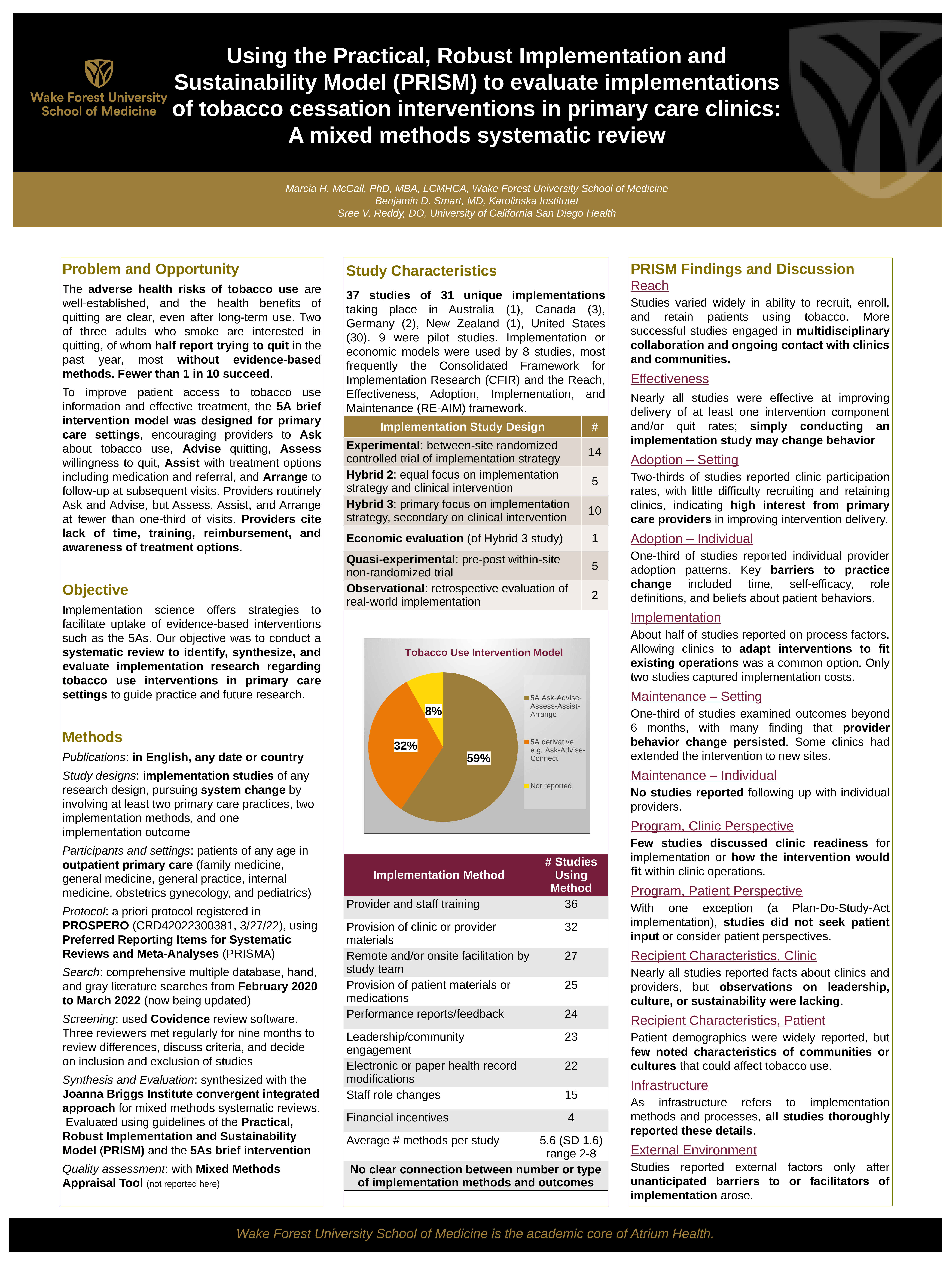
In the Tobacco Use Intervention Model pie chart, what share is labelled for 5A derivative e.g. Ask-Advise-Connect? 32% How many slices does the Tobacco Use Intervention Model pie chart have? 3 In the Tobacco Use Intervention Model pie chart, what colour is the Not reported slice? yellow Which slice of the Tobacco Use Intervention Model pie chart is the largest? 5A Ask-Advise-Assess-Assist-Arrange What kind of chart is the Tobacco Use Intervention Model chart? pie chart In the Tobacco Use Intervention Model pie chart, what is the difference in percentage points between the 5A Ask-Advise-Assess-Assist-Arrange slice and the 5A derivative slice? 27 What is the title of the pie chart on the slide? Tobacco Use Intervention Model Which slice of the Tobacco Use Intervention Model pie chart is the smallest? Not reported How many entries does the legend of the Tobacco Use Intervention Model pie chart list? 3 In the Tobacco Use Intervention Model pie chart, which is larger: the 5A derivative slice or the Not reported slice? 5A derivative e.g. Ask-Advise-Connect In the Tobacco Use Intervention Model pie chart, what share is labelled for Not reported? 8% In the Tobacco Use Intervention Model pie chart, what share is labelled for 5A Ask-Advise-Assess-Assist-Arrange? 59%